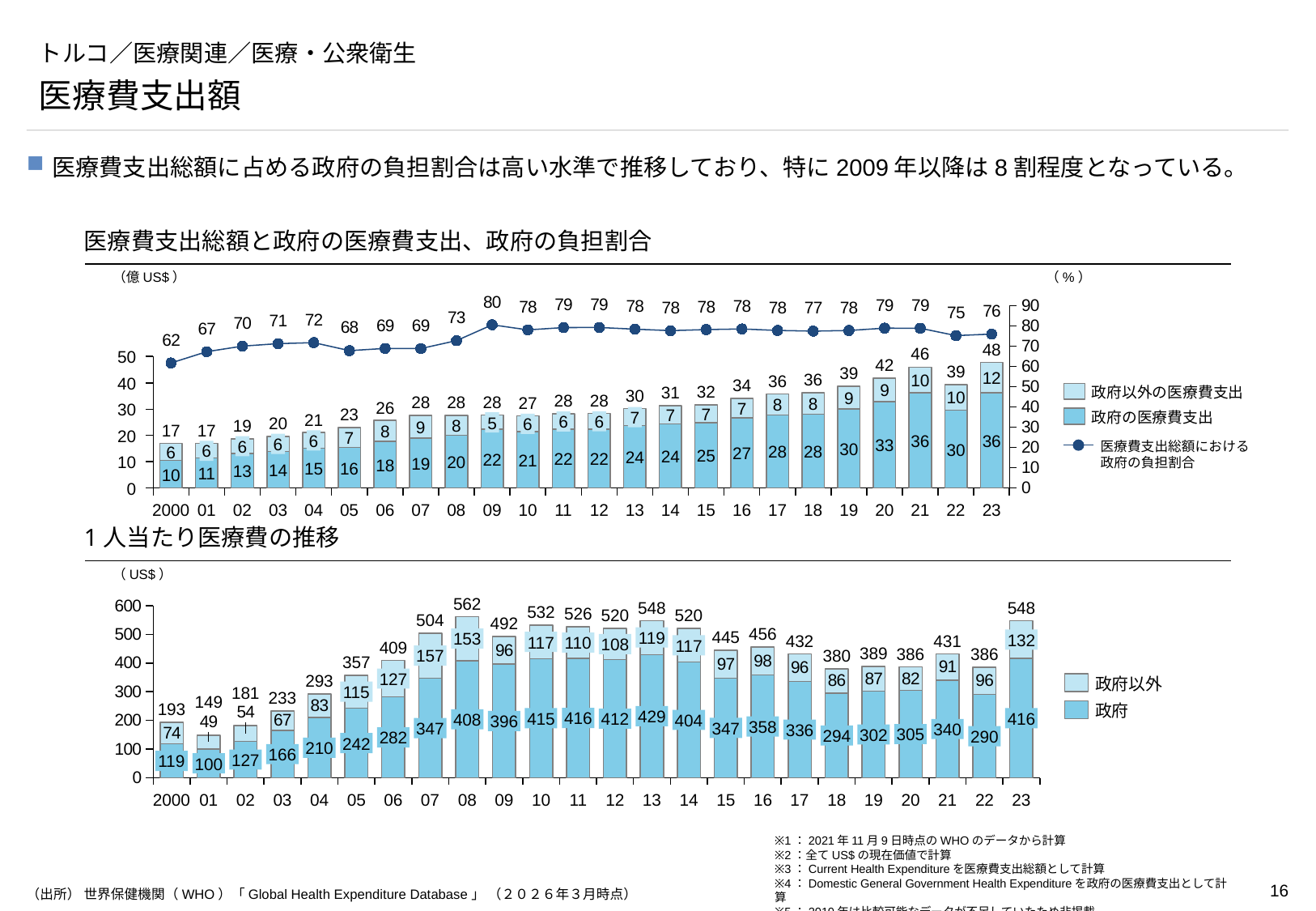
How many years are shown on the x axis of the top chart? 24 What kind of chart is the bottom chart (1人当たり医療費の推移)? Stacked bar chart In the top chart (医療費支出総額と政府の医療費支出、政府の負担割合), what is the 医療費支出総額における政府の負担割合 for 2009? 80 In the top chart, what is the difference between the total health expenditure in 23 and in 22? 9 In the bottom chart, what is the 政府 value for 23? 416 In the bottom chart (1人当たり医療費の推移), which year has the highest total per-capita health expenditure? 08 In the top chart, which year has the highest total health expenditure (top-of-bar label)? 23 In the bottom chart, which year has the lowest total per-capita health expenditure? 01 How many series does the legend of the top chart list? 3 In the bottom chart, which year has the larger total per-capita health expenditure, 10 or 11? 10 In the bottom chart, what is the difference between the 政府以外 value in 23 and in 22? 36 In the top chart, which year has the lowest 医療費支出総額における政府の負担割合? 2000